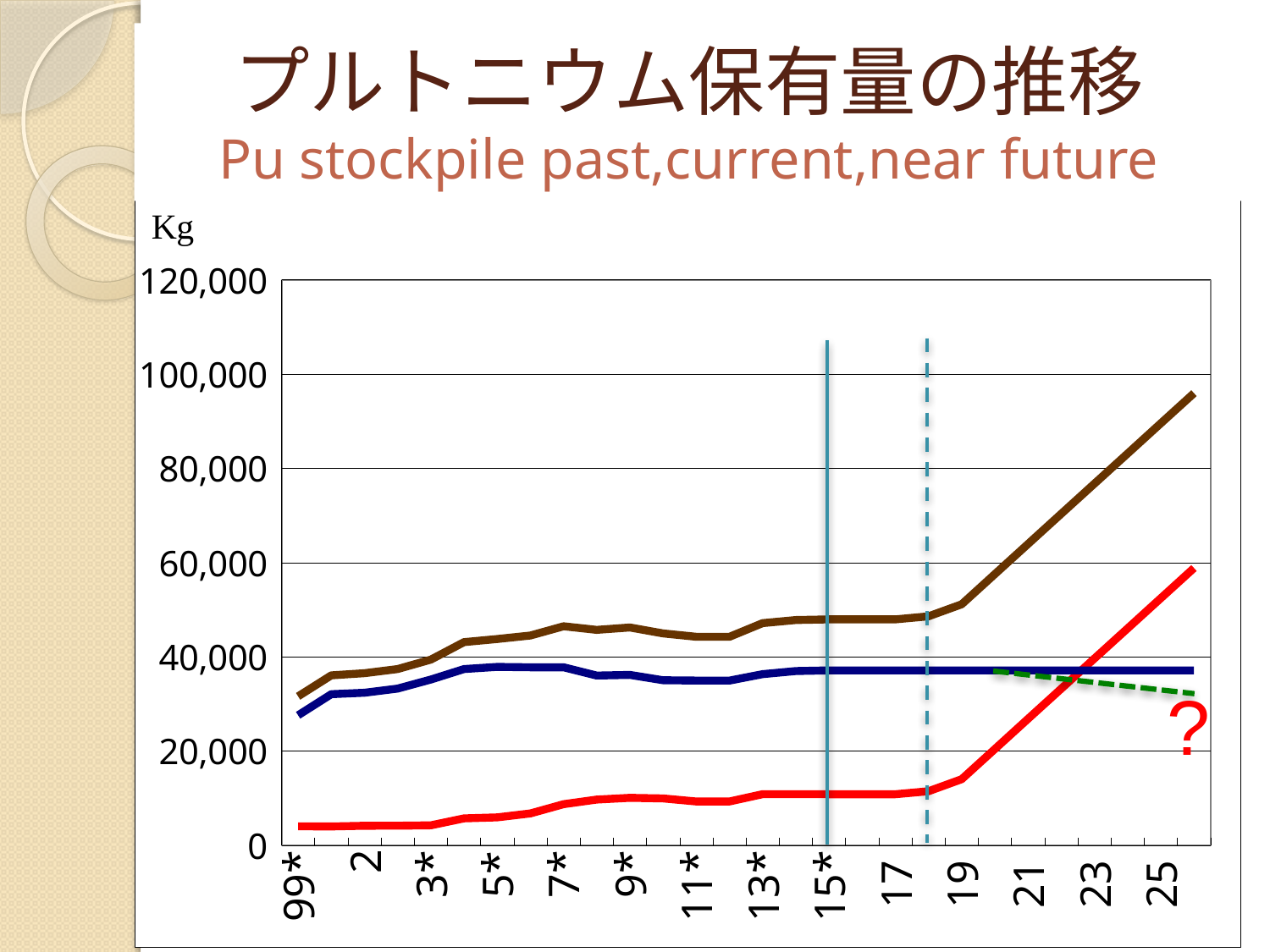
Is the value of the red line at 25 greater or less than 40,000? greater Is the value of the blue line at 99* greater or less than 40,000? less Is the value of the brown line at 17 greater or less than 40,000? greater Does the brown line rise or fall between 19 and 25? rise At 25, which is higher, the brown line or the red line? brown line What unit is shown for the vertical axis of the chart? Kg Which line reaches the highest value on the chart, the brown, blue or red line? brown How many labels are shown along the x axis of the chart? 14 What is the English subtitle of the chart on the slide? Pu stockpile past,current,near future What kind of chart is shown on the slide? line chart